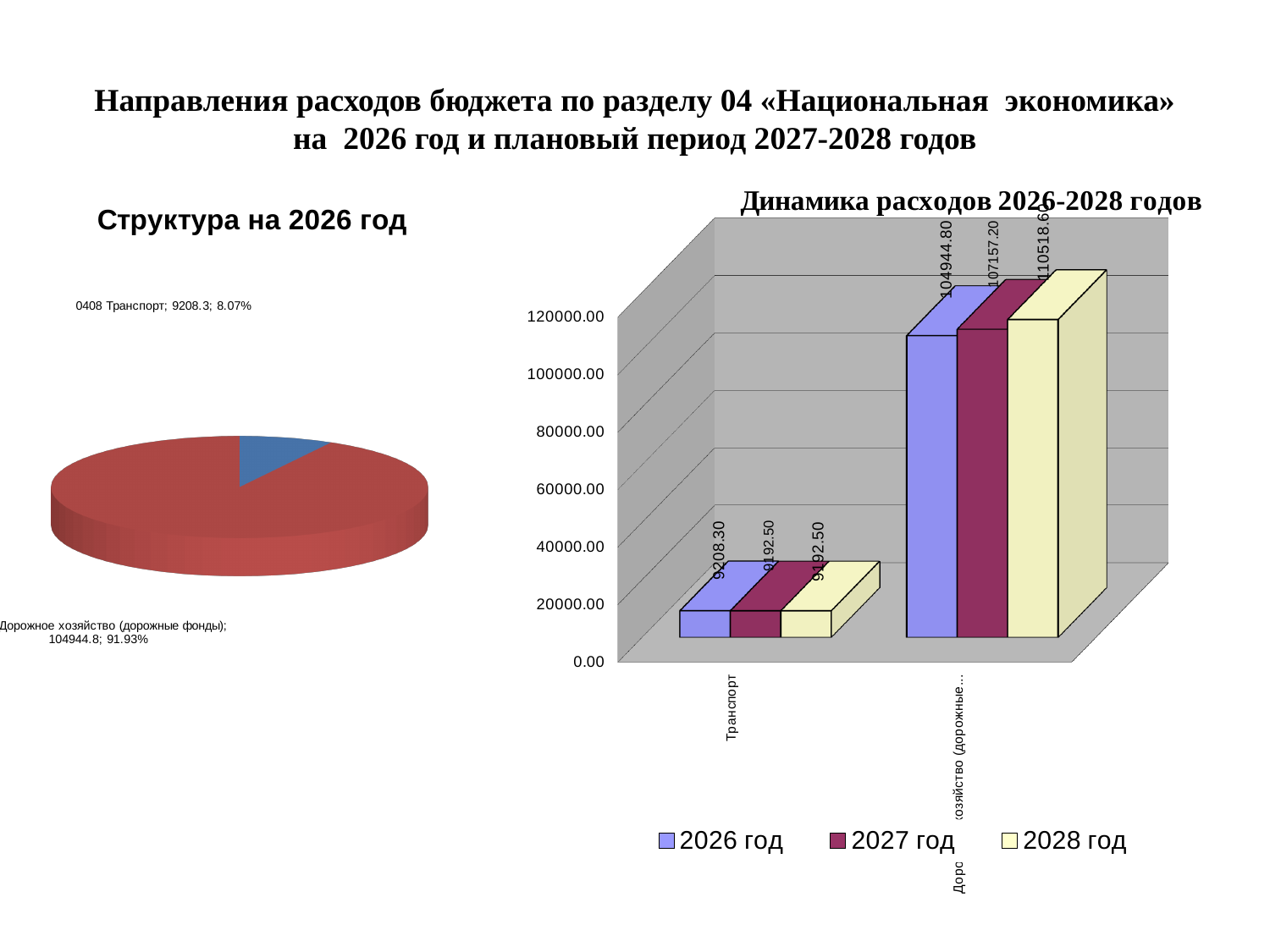
What kind of chart is "Динамика расходов 2026-2028 годов"? Bar chart In the chart "Динамика расходов 2026-2028 годов", is the 2028 год value for Дорожное хозяйство greater or less than 100000.00? greater In the pie chart "Структура на 2026 год", which slice is the largest? Дорожное хозяйство (дорожные фонды) In the chart "Динамика расходов 2026-2028 годов", what is the value for Дорожное хозяйство in 2027 год? 107157.20 In the chart "Динамика расходов 2026-2028 годов", what is the difference between the 2027 год and 2026 год values for Дорожное хозяйство? 2212.40 In the chart "Динамика расходов 2026-2028 годов", what is the value for Транспорт in 2028 год? 9192.50 What kind of chart is "Структура на 2026 год"? Pie chart In the chart "Динамика расходов 2026-2028 годов", what is the value for Транспорт in 2026 год? 9208.30 In the pie chart "Структура на 2026 год", what share does "0408 Транспорт" have? 8.07% In the pie chart "Структура на 2026 год", what is the value shown for "Дорожное хозяйство (дорожные фонды)"? 104944.8 In the chart "Динамика расходов 2026-2028 годов", how many series does the legend list? 3 How many slices does the pie chart "Структура на 2026 год" have? 2